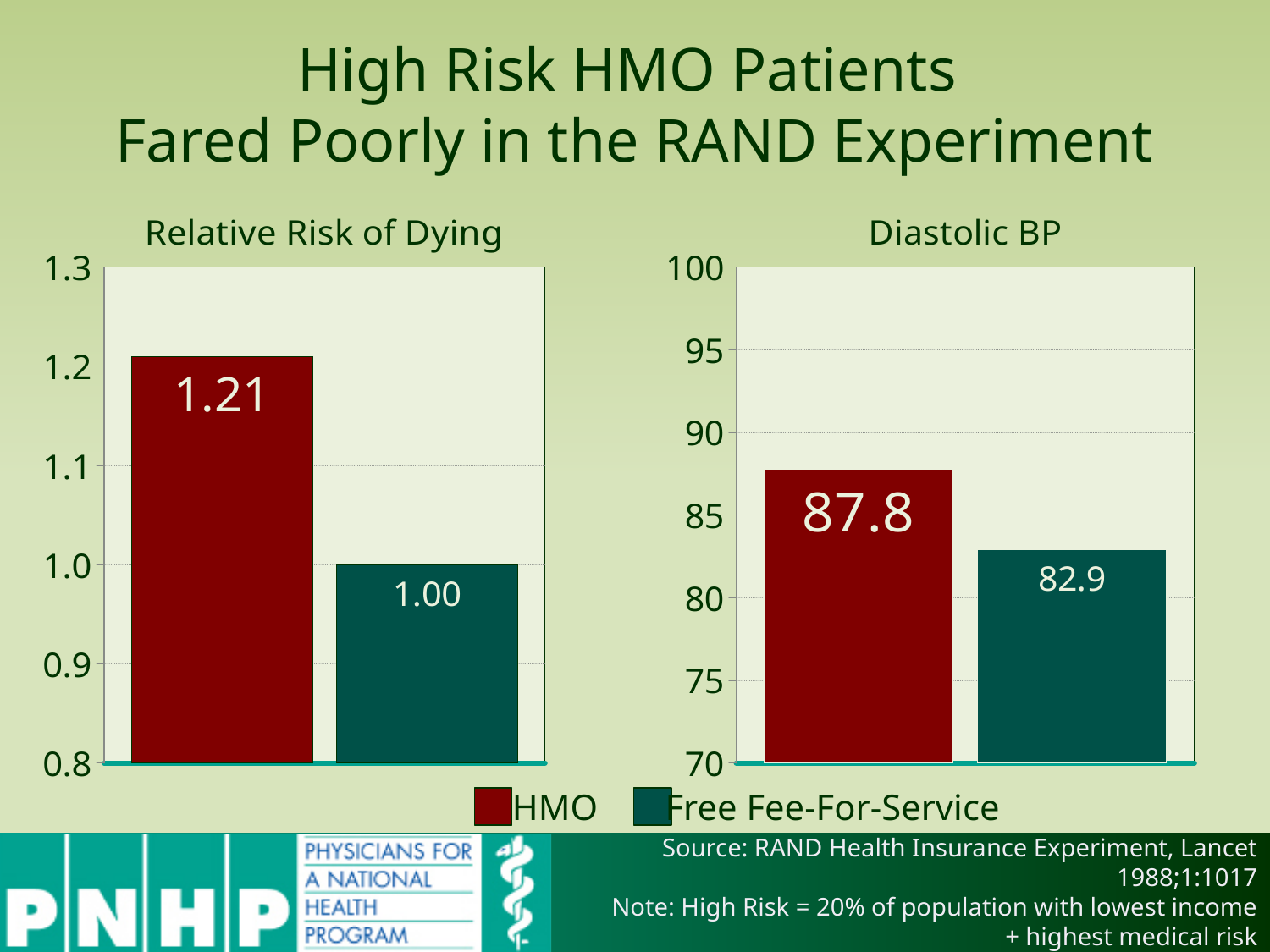
In the Diastolic BP chart, what is the difference between the HMO and Free Fee-For-Service values? 4.9 In the Diastolic BP chart, what is the value for Free Fee-For-Service? 82.9 In the Diastolic BP chart, which series has the higher value, HMO or Free Fee-For-Service? HMO In the Diastolic BP chart, is the value for HMO greater or less than 85? greater In the Diastolic BP chart, what is the value for HMO? 87.8 In the Relative Risk of Dying chart, what is the difference between the HMO and Free Fee-For-Service values? 0.21 In the Relative Risk of Dying chart, what is the value for Free Fee-For-Service? 1.00 What colour represents HMO in the legend? dark red In the Relative Risk of Dying chart, what is the value for HMO? 1.21 What kind of chart is the Diastolic BP chart? bar chart How many series does the legend list? 2 In the Relative Risk of Dying chart, which series has the lowest value? Free Fee-For-Service